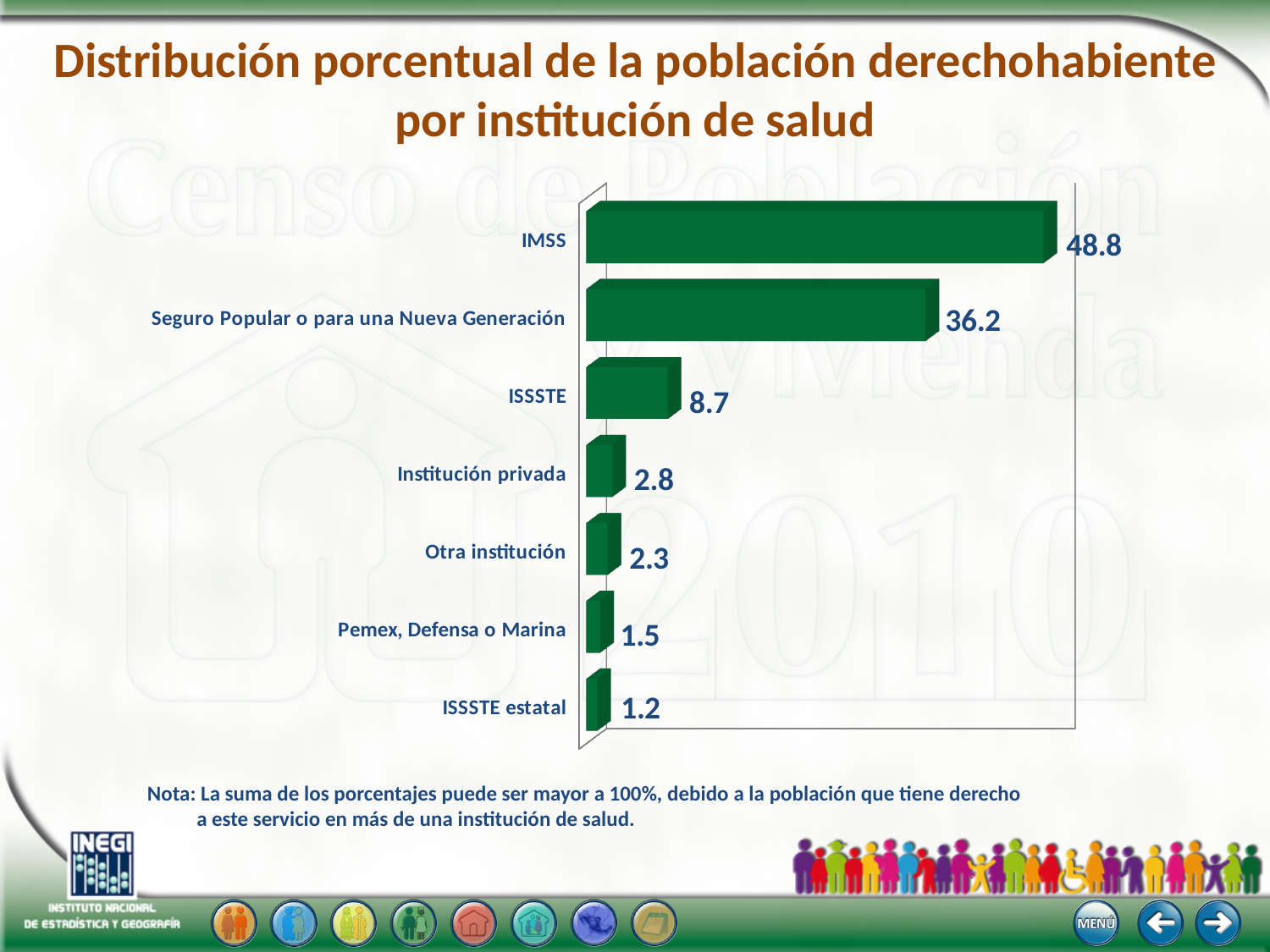
Which institution has the lowest value? ISSSTE estatal How many institutions are shown in the chart? 7 Which is larger, the value for ISSSTE or the value for Institución privada? ISSSTE What is the value for Pemex, Defensa o Marina? 1.5 What is the value for IMSS? 48.8 What is the value for Seguro Popular o para una Nueva Generación? 36.2 What kind of chart is shown on the slide? Bar chart Which institution has the highest value? IMSS What is the difference between the values for Institución privada and Otra institución? 0.5 What is the difference between the values for IMSS and Seguro Popular o para una Nueva Generación? 12.6 What is the title of the slide? Distribución porcentual de la población derechohabiente por institución de salud What is the value for ISSSTE? 8.7